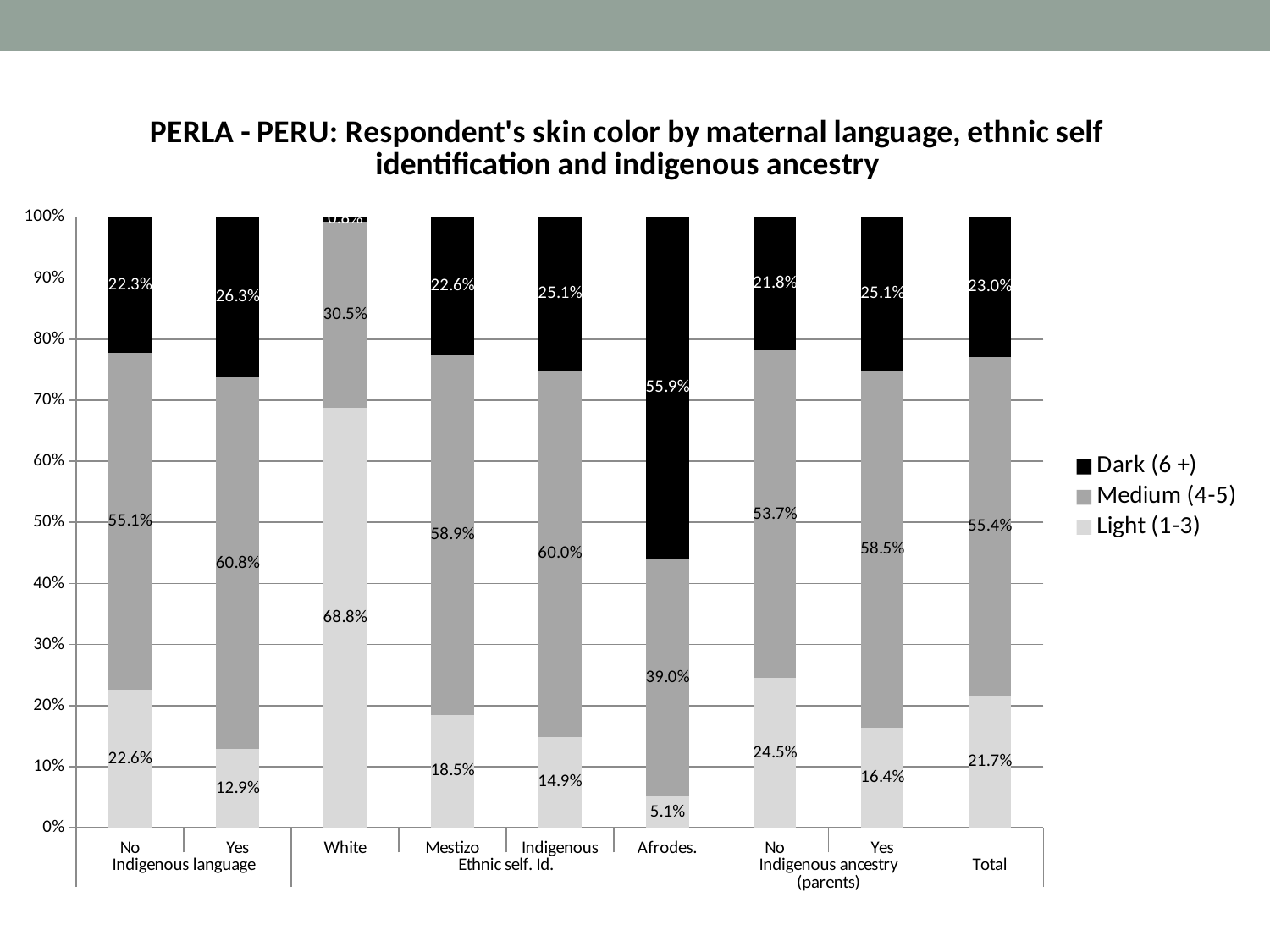
Which has a larger Medium (4-5) share: the Yes category under Indigenous language or the Indigenous category under Ethnic self. Id.? Yes (Indigenous language) What is the Dark (6 +) share for the Yes category under Indigenous language? 26.3% What is the difference between the Dark (6 +) share for Afrodes. and the Dark (6 +) share for Mestizo? 33.3% How many bars are plotted in the chart? 9 Which category has the lowest Light (1-3) share? Afrodes. What type of chart is shown on the slide? Stacked bar chart What is the Medium (4-5) share for the Total bar? 55.4% What is the Light (1-3) share for Mestizo? 18.5% What is the Light (1-3) share for the Afrodes. category? 5.1% How many series does the legend list? 3 Which category has the highest Light (1-3) share? White Which legend entry is shown in black? Dark (6 +)